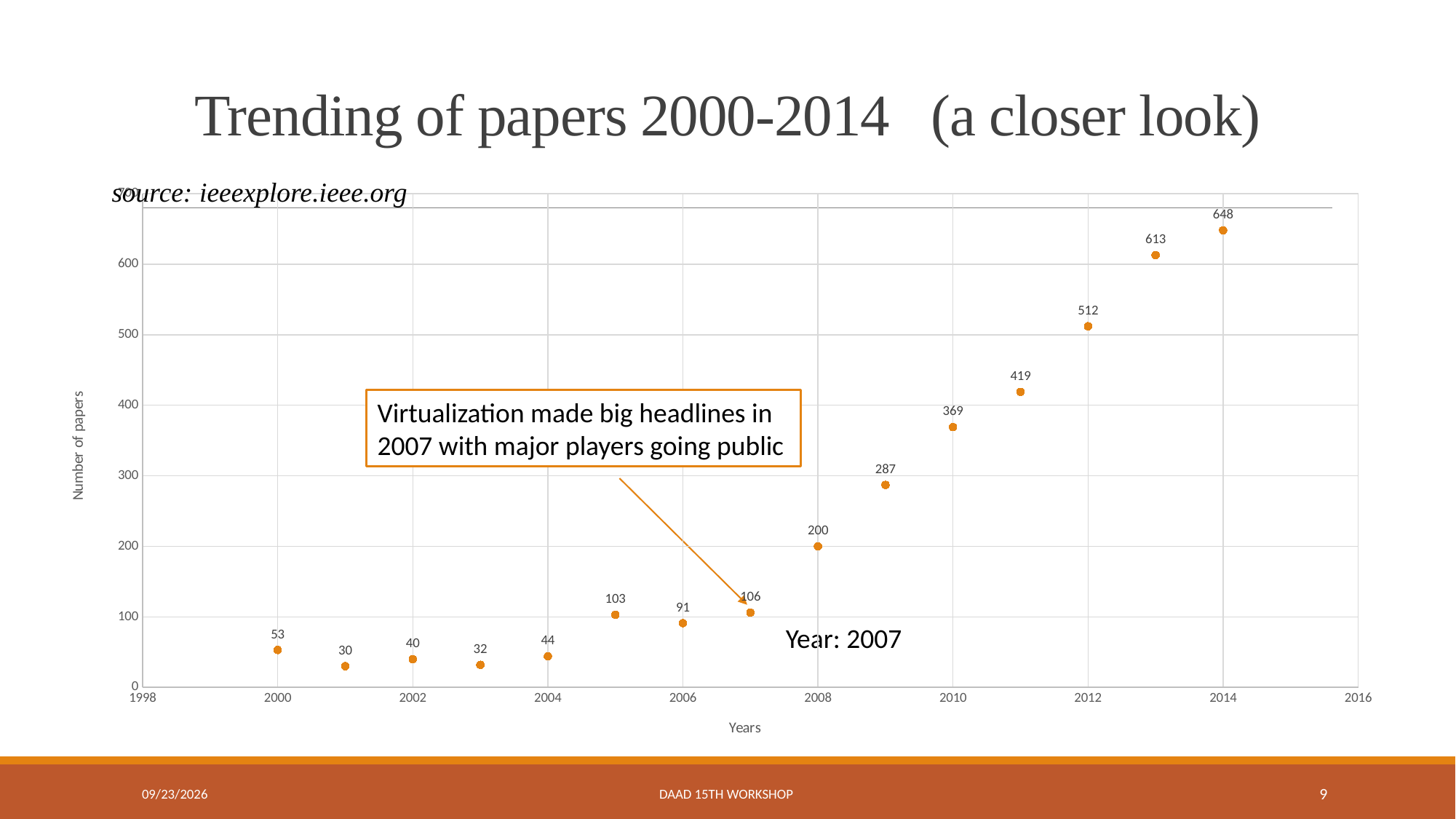
What kind of chart is shown on the slide? scatter chart Is the number of papers for 2010 greater or less than 300? greater What is the number of papers for 2007? 106 What is the difference in the number of papers between 2014 and 2013? 35 What is the label of the vertical axis? Number of papers What is the number of papers for 2001? 30 What is the difference in the number of papers between 2008 and 2007? 94 Which year has the lowest number of papers? 2001 Which year has the highest number of papers? 2014 Which year has more papers, 2005 or 2006? 2005 How many data points are plotted on the chart? 15 What is the number of papers for 2012? 512